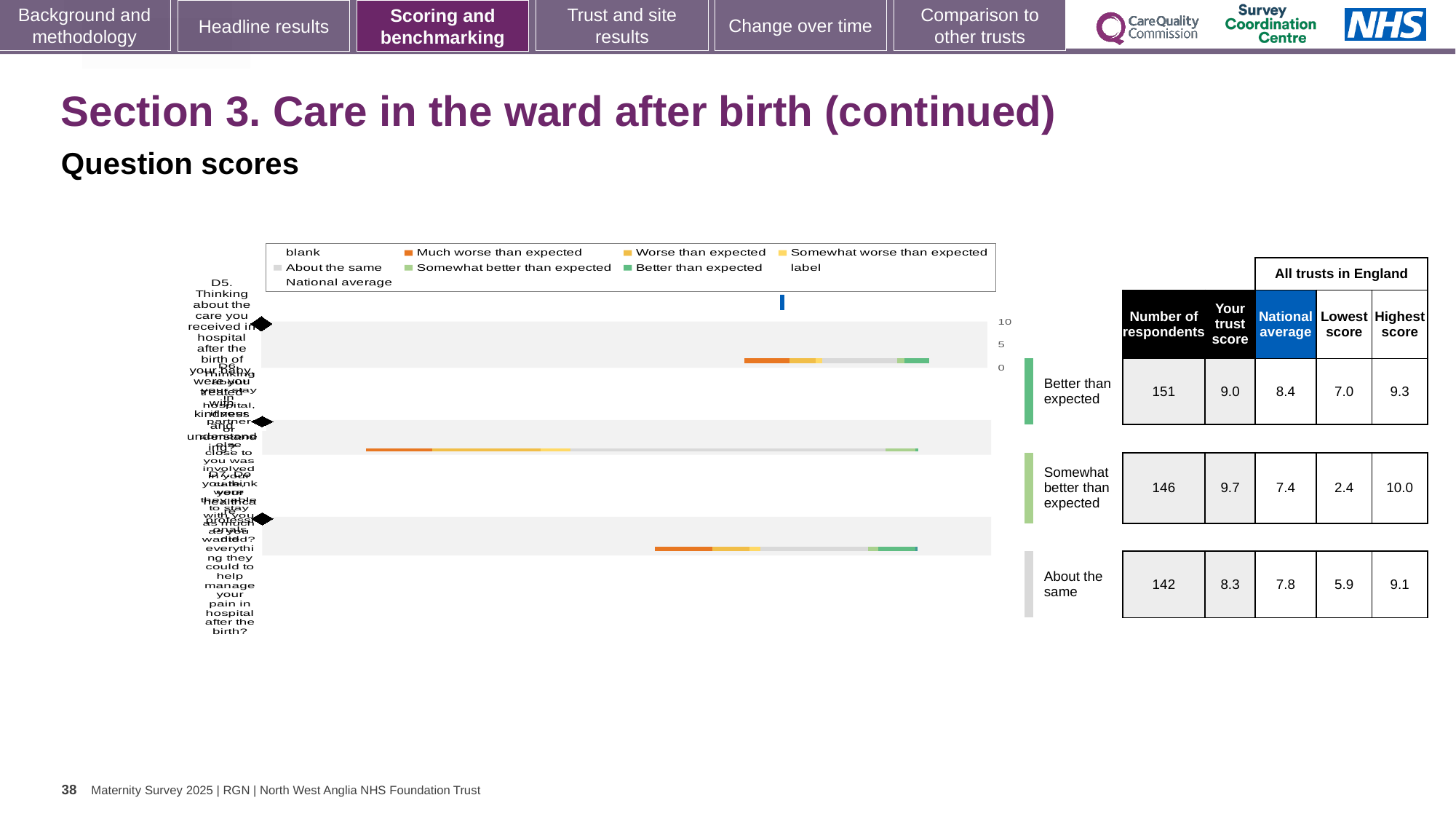
What is the highest tick value shown on the chart's axis? 10 How many question rows (bars) are plotted in the chart? 3 In the table beside the chart, which is larger for the 'About the same' row: 'Your trust score' or the national average? Your trust score In the table beside the chart, which row has the highest 'Your trust score'? Somewhat better than expected In the table beside the chart, what is 'Your trust score' for the 'Somewhat better than expected' row? 9.7 In the table beside the chart, what is the number of respondents for the 'Better than expected' row? 151 What kind of chart is shown on the slide? bar chart In the table beside the chart, what is the lowest score across all trusts in England for the 'Somewhat better than expected' row? 2.4 What colour does the legend use for 'Much worse than expected'? orange How many entries does the chart legend list? 9 In the table beside the chart, what is the difference between 'Your trust score' and the national average for the 'Better than expected' row? 0.6 In the table beside the chart, what is the national average for the 'About the same' row? 7.8